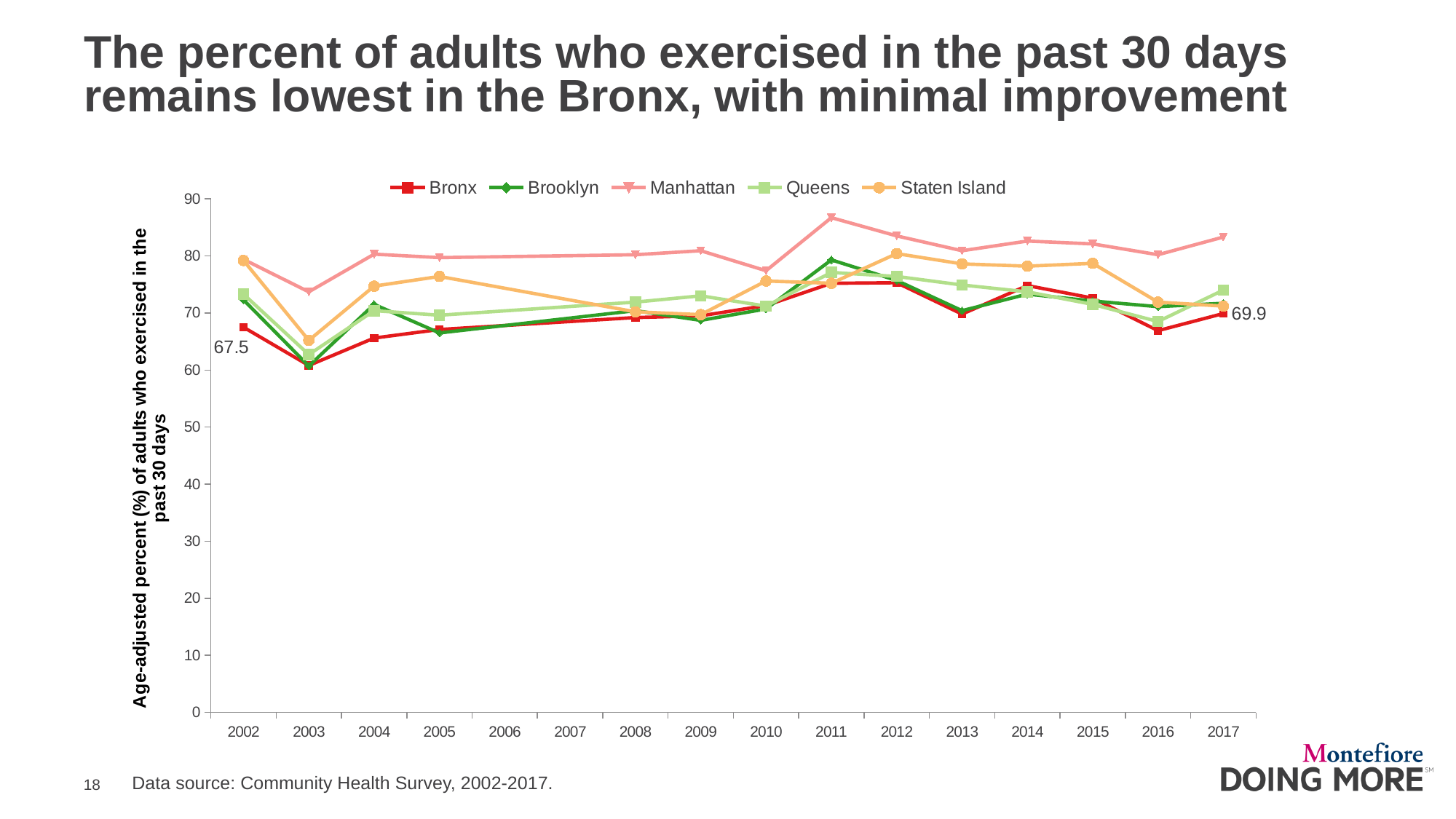
What is the value for the Bronx in 2017? 69.9 What is the value for the Bronx in 2002? 67.5 Which borough has the highest value in 2011? Manhattan Is the value for Manhattan in 2011 greater or less than 80? greater What kind of chart is shown on the slide? line chart Is the value for the Bronx in 2003 greater or less than 70? less What is the title of the vertical axis? Age-adjusted percent (%) of adults who exercised in the past 30 days In 2017, which is larger: the value for Manhattan or the value for the Bronx? Manhattan By how much did the Bronx value change from 2002 to 2017? 2.4 Does the Manhattan value rise or fall from 2002 to 2003? fall Which borough has the lowest value in 2002? Bronx How many series does the legend list? 5